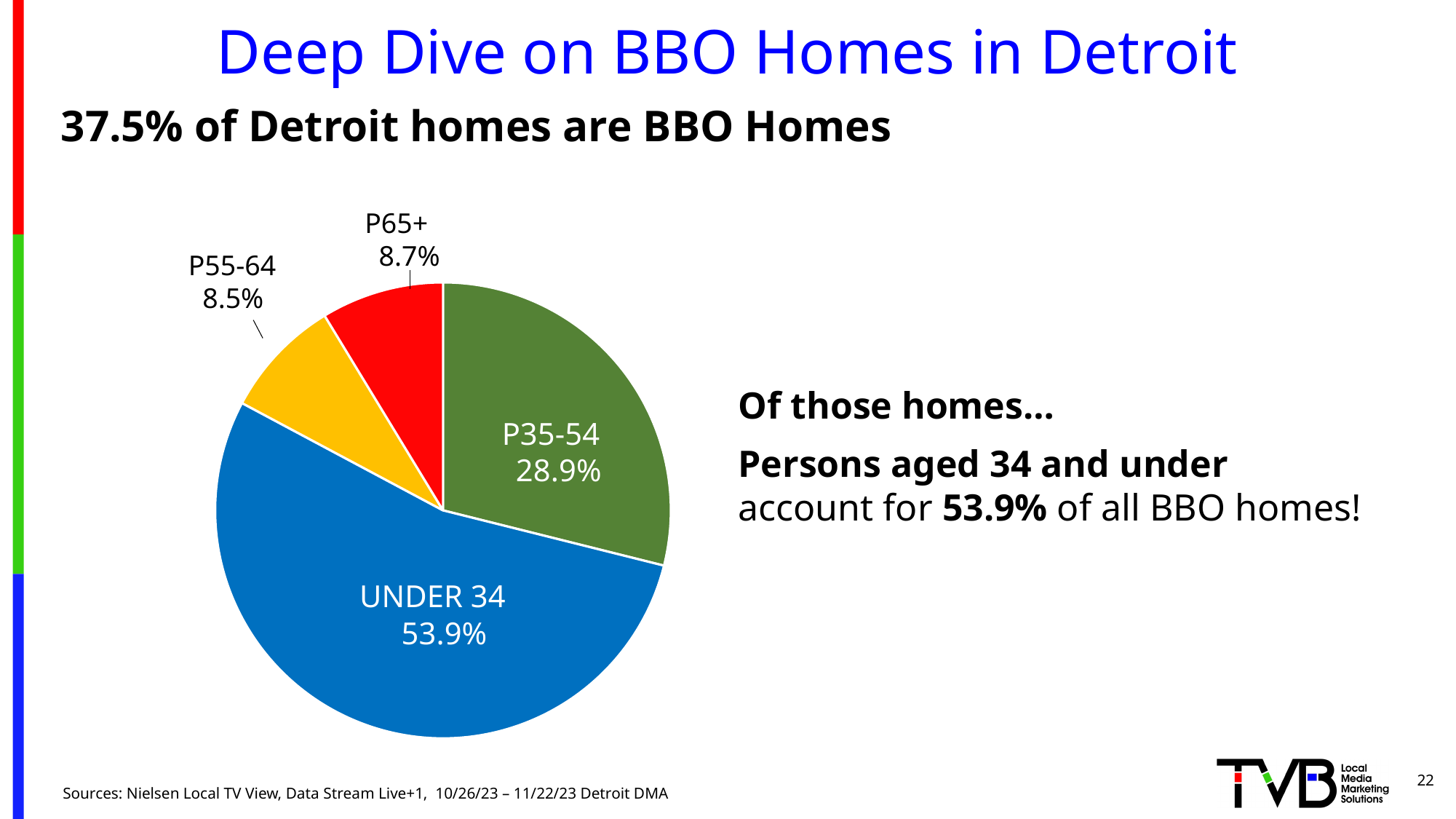
Which is larger, the P35-54 slice or the P65+ slice? P35-54 Which slice of the pie is the smallest? P55-64 What percentage is shown for the P65+ slice? 8.7% What percentage is shown for the P55-64 slice? 8.5% What is the combined share of the P55-64 and P65+ slices? 17.2% What percentage is shown for the P35-54 slice? 28.9% What kind of chart is shown on the slide? pie chart How many slices does the pie chart have? 4 What colour is the UNDER 34 slice? blue What is the difference in percentage points between the UNDER 34 slice and the P35-54 slice? 25.0% Which slice of the pie is the largest? UNDER 34 What share of BBO homes is the UNDER 34 slice? 53.9%